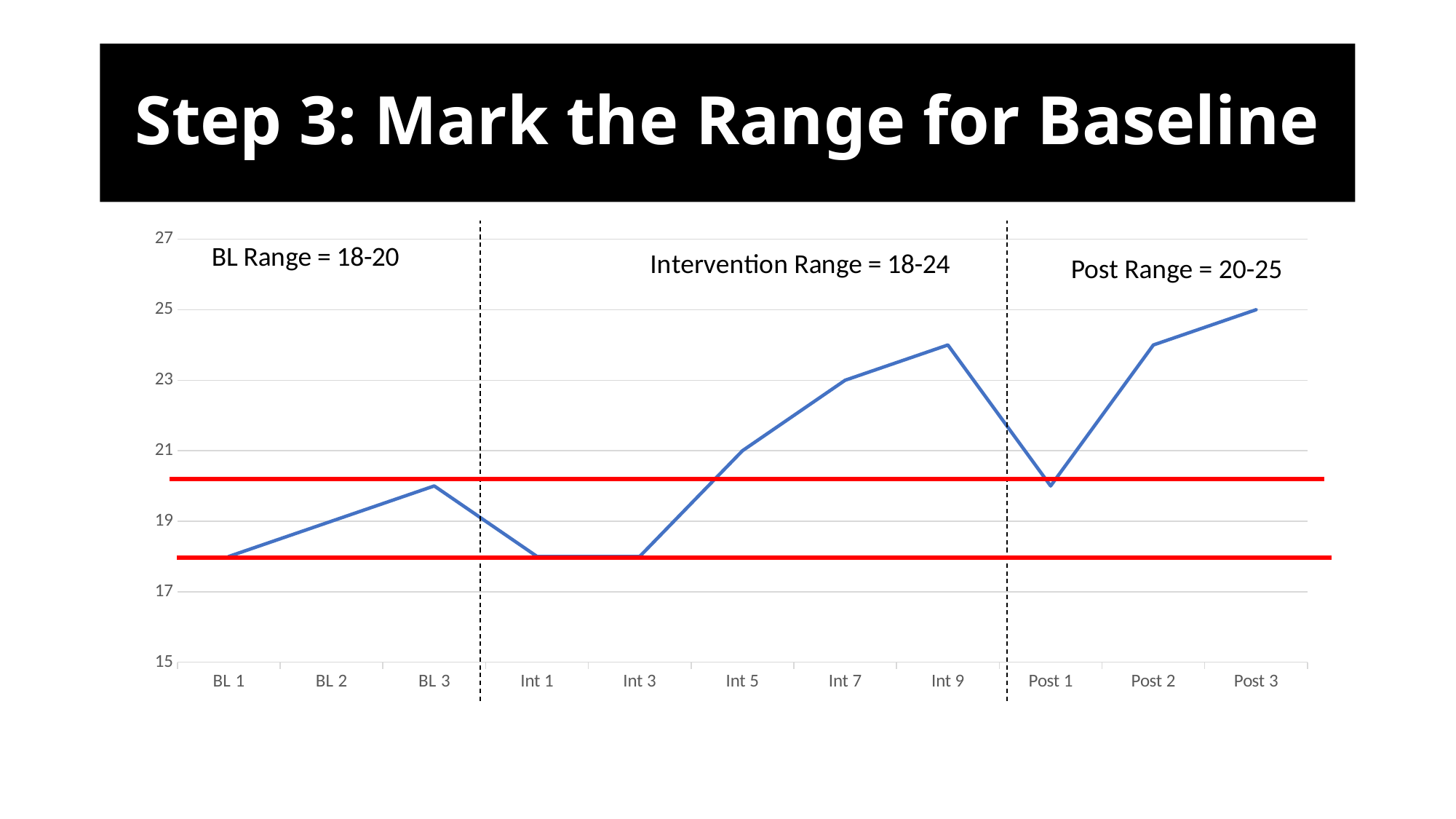
Is the value for Int 9 greater or less than 23? greater How many data points are plotted along the x axis? 11 Is the value for Post 1 greater or less than 21? less What is the value at BL 2? 19 What is the value at Int 7? 23 Which point on the x axis has the highest value? Post 3 What is the value at Post 3? 25 What does the slide state the BL Range is? 18-20 What kind of chart is shown on the slide? line chart Do the values rise or fall from Int 1 to Int 9? rise Which is larger, the value at Int 7 or the value at BL 3? Int 7 What is the difference between the values at Post 3 and Int 7? 2